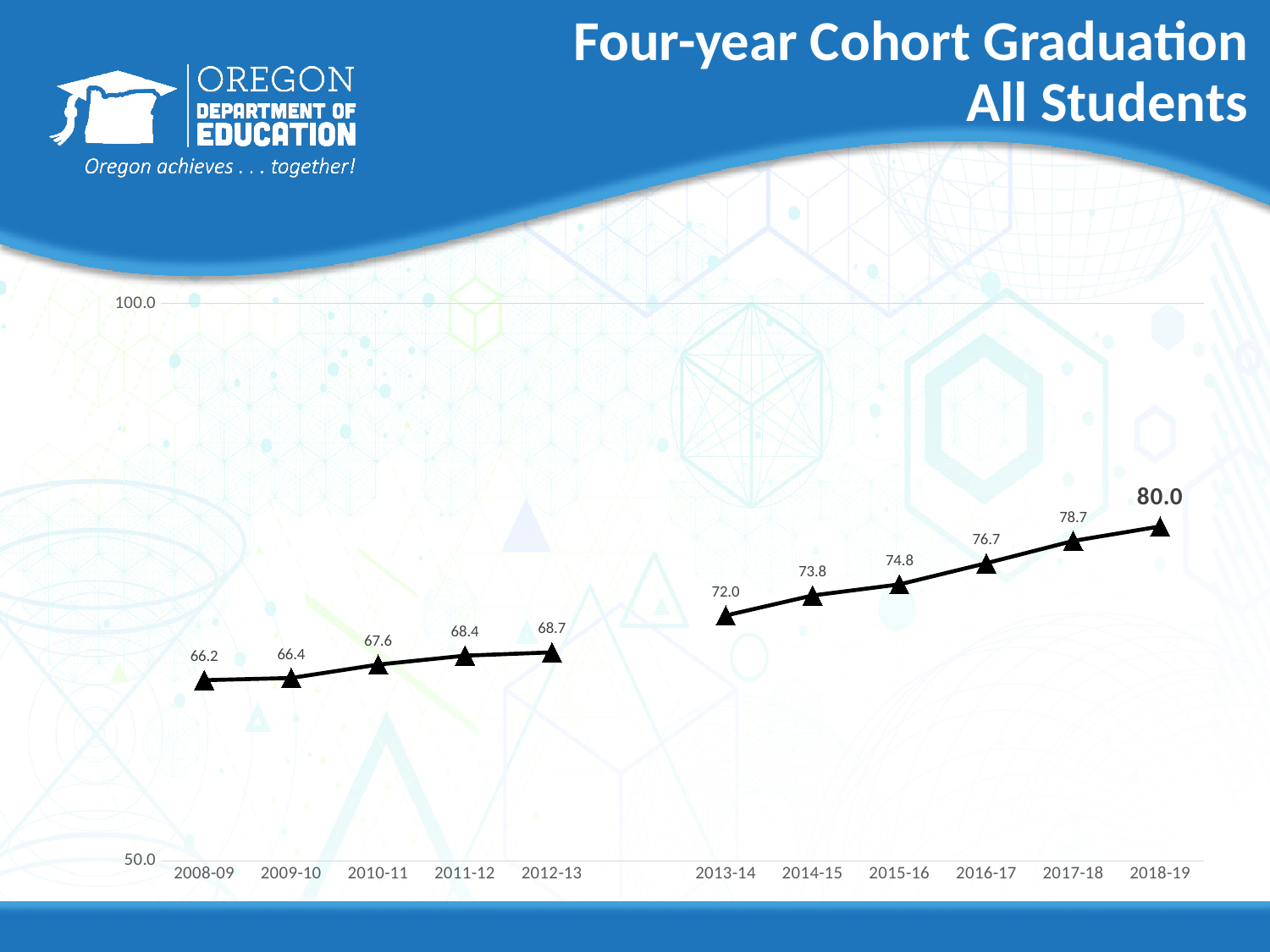
What is the value plotted for 2013-14? 72.0 What is the four-year cohort graduation value for 2018-19? 80.0 What is the difference between the 2018-19 value and the 2008-09 value? 13.8 What kind of chart is shown on the slide? line chart Which is larger, the value for 2014-15 or the value for 2011-12? 2014-15 Which school year has the lowest graduation value? 2008-09 What is the difference between the 2013-14 value and the 2012-13 value? 3.3 What is the value plotted for 2008-09? 66.2 Do the values rise or fall from 2008-09 to 2018-19? rise How many school years are plotted on the chart? 11 Which school year has the highest graduation value? 2018-19 What is the value plotted for 2016-17? 76.7